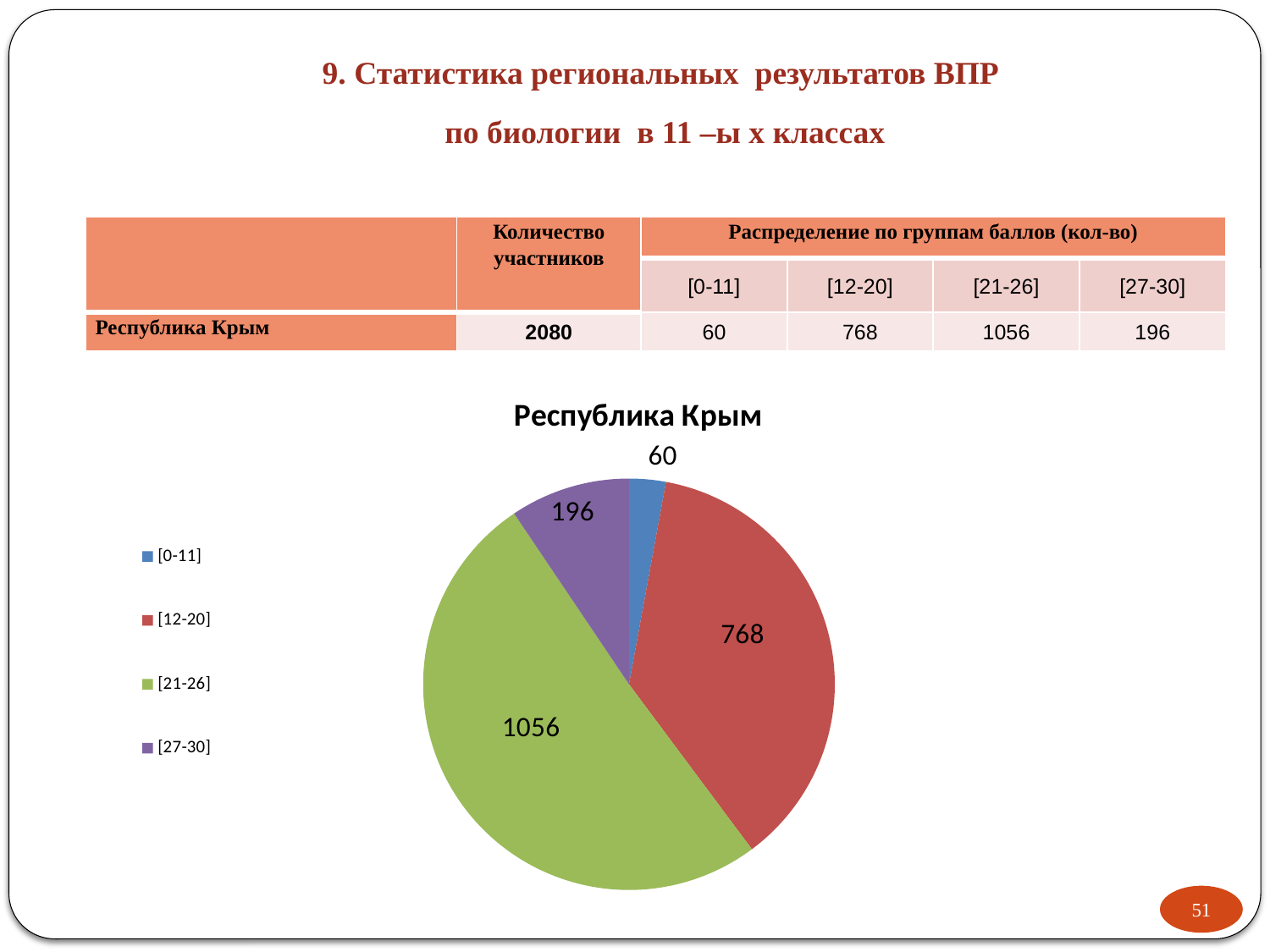
Which is larger, the [27-30] slice or the [0-11] slice? [27-30] Which score group has the smallest slice? [0-11] What is the value of the [0-11] slice? 60 What is the value of the [21-26] slice? 1056 What is the title of the chart? Республика Крым What is the difference between the [21-26] and [12-20] values? 288 What type of chart is shown on the slide? pie chart What is the value of the [27-30] slice? 196 Which score group has the largest slice? [21-26] What is the value of the [12-20] slice? 768 How many slices does the pie chart have? 4 How many entries does the chart legend list? 4